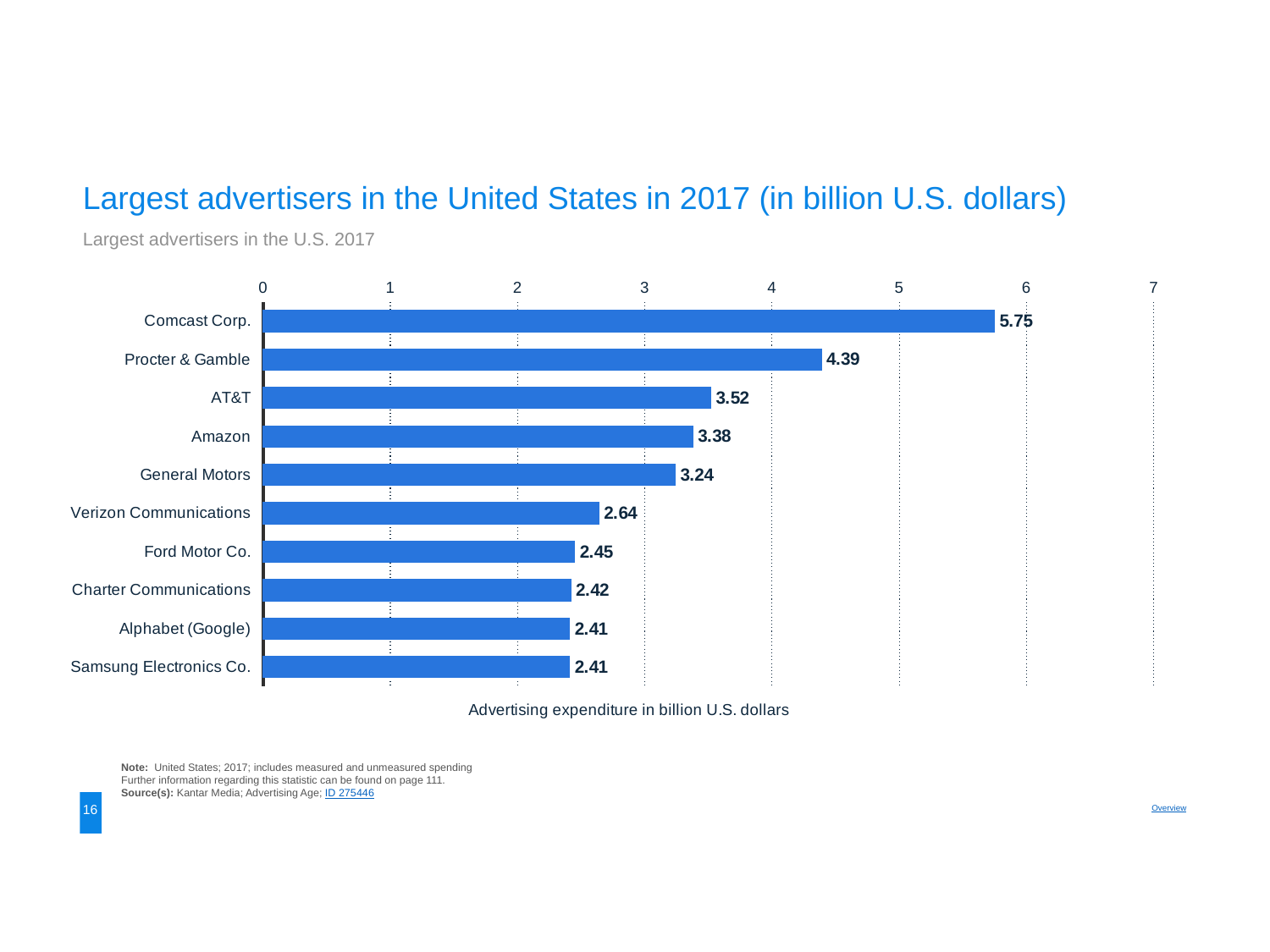
How many advertisers are shown in the chart? 10 What is the difference in advertising expenditure between Comcast Corp. and Procter & Gamble? 1.36 Which has a larger advertising expenditure, Procter & Gamble or AT&T? Procter & Gamble What is the advertising expenditure for Verizon Communications? 2.64 What is the advertising expenditure for Comcast Corp.? 5.75 What is the difference in advertising expenditure between AT&T and General Motors? 0.28 What kind of chart is shown on the slide? Bar chart Which has a larger advertising expenditure, Ford Motor Co. or General Motors? General Motors What is the advertising expenditure for Amazon? 3.38 Is the value for Procter & Gamble greater or less than 4? greater Which advertiser has the highest advertising expenditure? Comcast Corp. What is the label of the horizontal axis? Advertising expenditure in billion U.S. dollars